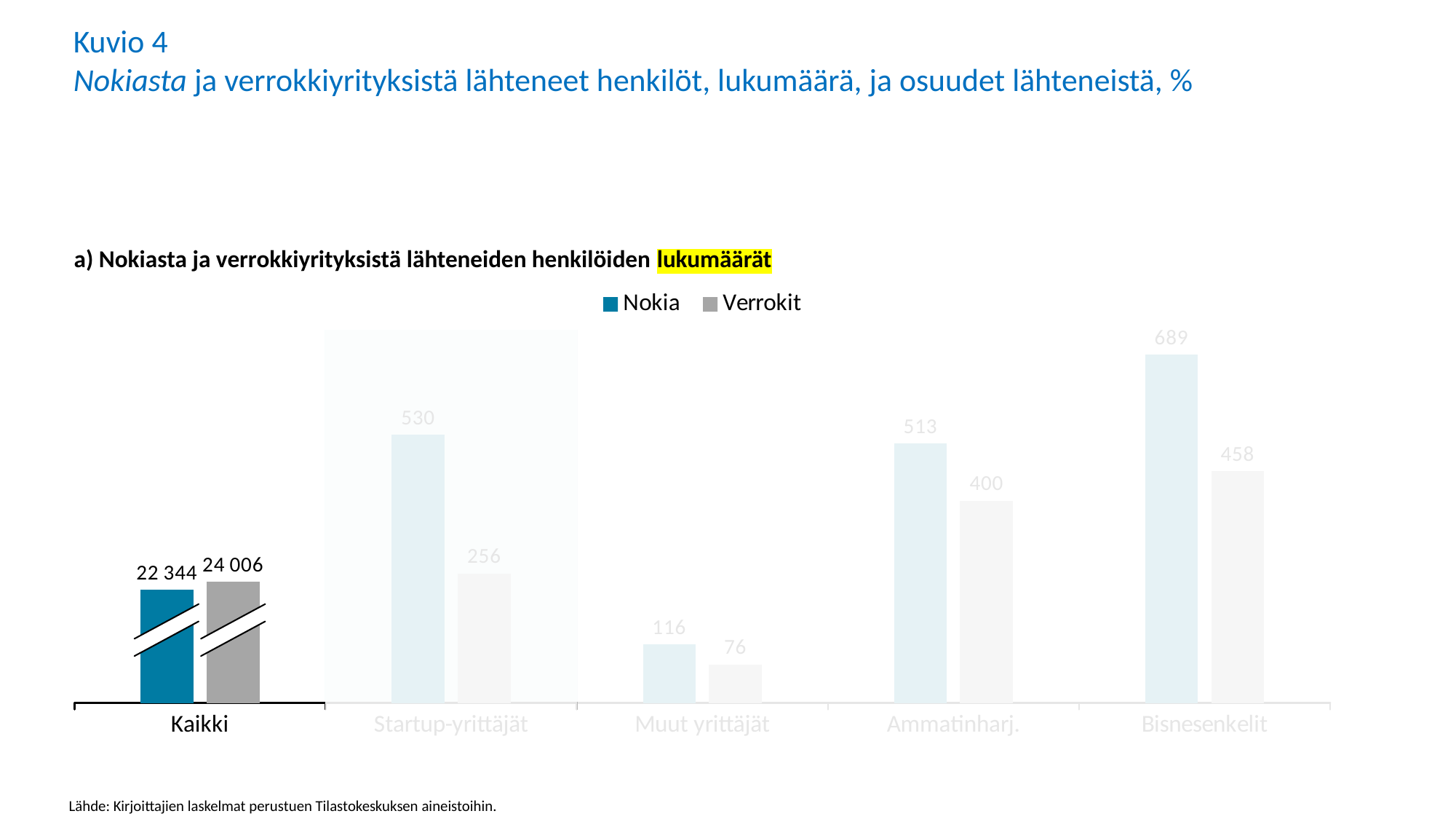
What is the difference between the Verrokit and Nokia values for Kaikki? 1 662 What is the difference between the Nokia and Verrokit values for Startup-yrittäjät? 274 What are the two series named in the legend? Nokia and Verrokit Which category has the lowest Verrokit value? Muut yrittäjät How many categories are shown on the x axis? 5 Which is larger for Kaikki, the Nokia value or the Verrokit value? Verrokit What kind of chart is shown on the slide? bar chart What is the Verrokit value for Ammatinharj.? 400 What is the Nokia value for Bisnesenkelit? 689 What is the Nokia value for the Kaikki category? 22 344 What is the Verrokit value for the Kaikki category? 24 006 How many series does the legend list? 2